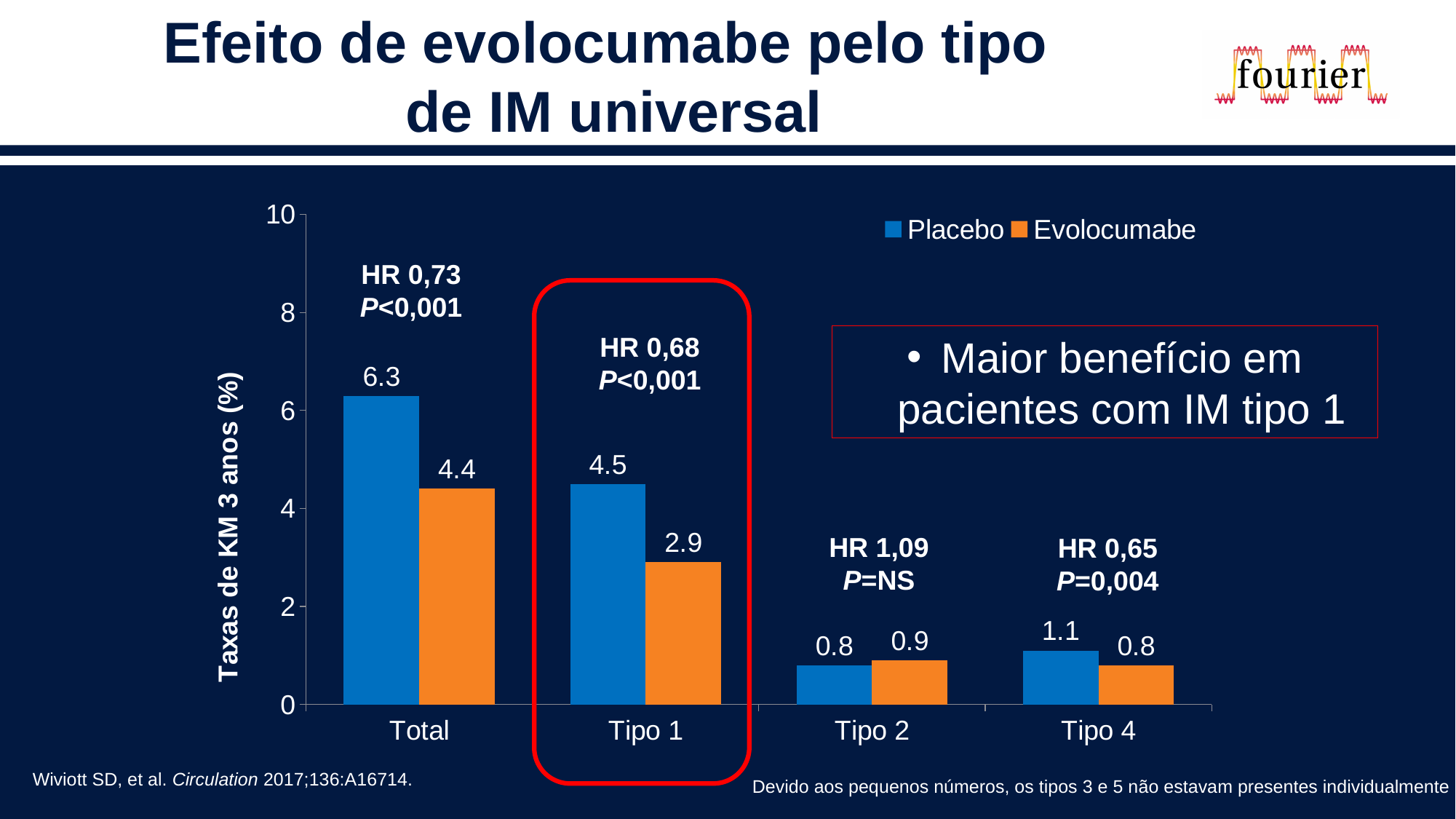
Is the Placebo value for Total greater or less than 6? greater What is the Placebo value for Tipo 4? 1.1 What is the Placebo value for Total? 6.3 What kind of chart is shown on the slide? bar chart How many series does the legend list? 2 What is the label of the y axis? Taxas de KM 3 anos (%) For Tipo 2, which is larger: the Placebo value or the Evolocumabe value? Evolocumabe Which category has the highest Placebo value? Total Which category has the lowest Evolocumabe value? Tipo 4 What is the Evolocumabe value for Tipo 1? 2.9 How many categories are shown on the x axis? 4 What is the difference between the Placebo and Evolocumabe values for Tipo 1? 1.6